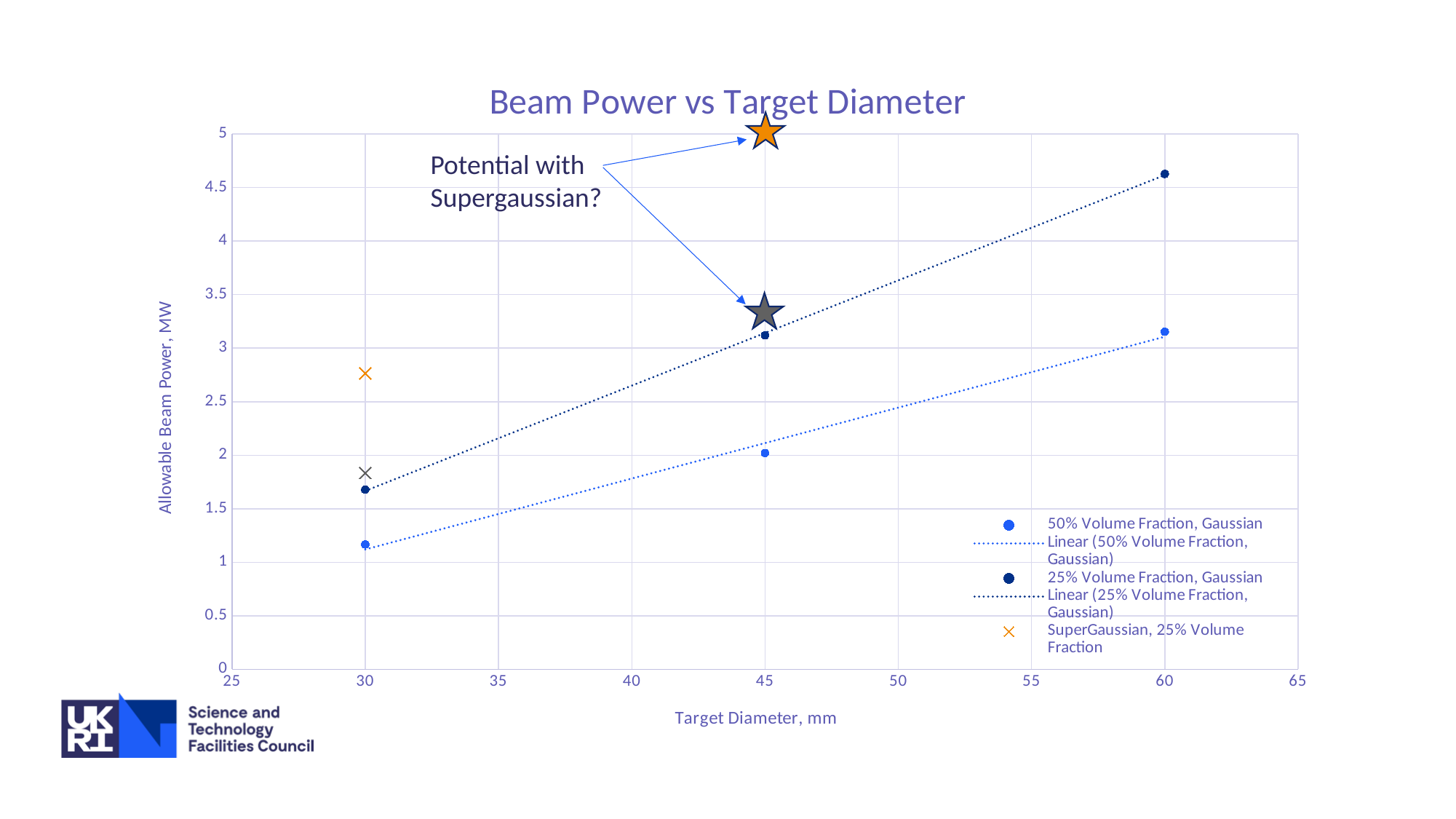
At 45 mm target diameter, which series has the higher allowable beam power: 25% Volume Fraction, Gaussian or 50% Volume Fraction, Gaussian? 25% Volume Fraction, Gaussian Is the value for SuperGaussian, 25% Volume Fraction at 30 mm target diameter greater or less than 2.5? greater What is the title of the chart? Beam Power vs Target Diameter Does the allowable beam power for the 25% Volume Fraction, Gaussian series rise or fall as target diameter increases? rise Is the value for 25% Volume Fraction, Gaussian at 60 mm target diameter greater or less than 4? greater What kind of chart is shown on the slide? scatter chart How many entries does the chart legend list? 5 How many data points are plotted for the 50% Volume Fraction, Gaussian series? 3 At 30 mm target diameter, which is higher: the SuperGaussian, 25% Volume Fraction point or the 25% Volume Fraction, Gaussian point? SuperGaussian, 25% Volume Fraction Is the value for 50% Volume Fraction, Gaussian at 30 mm target diameter greater or less than 1.5? less At which target diameter does the 50% Volume Fraction, Gaussian series reach its highest allowable beam power? 60